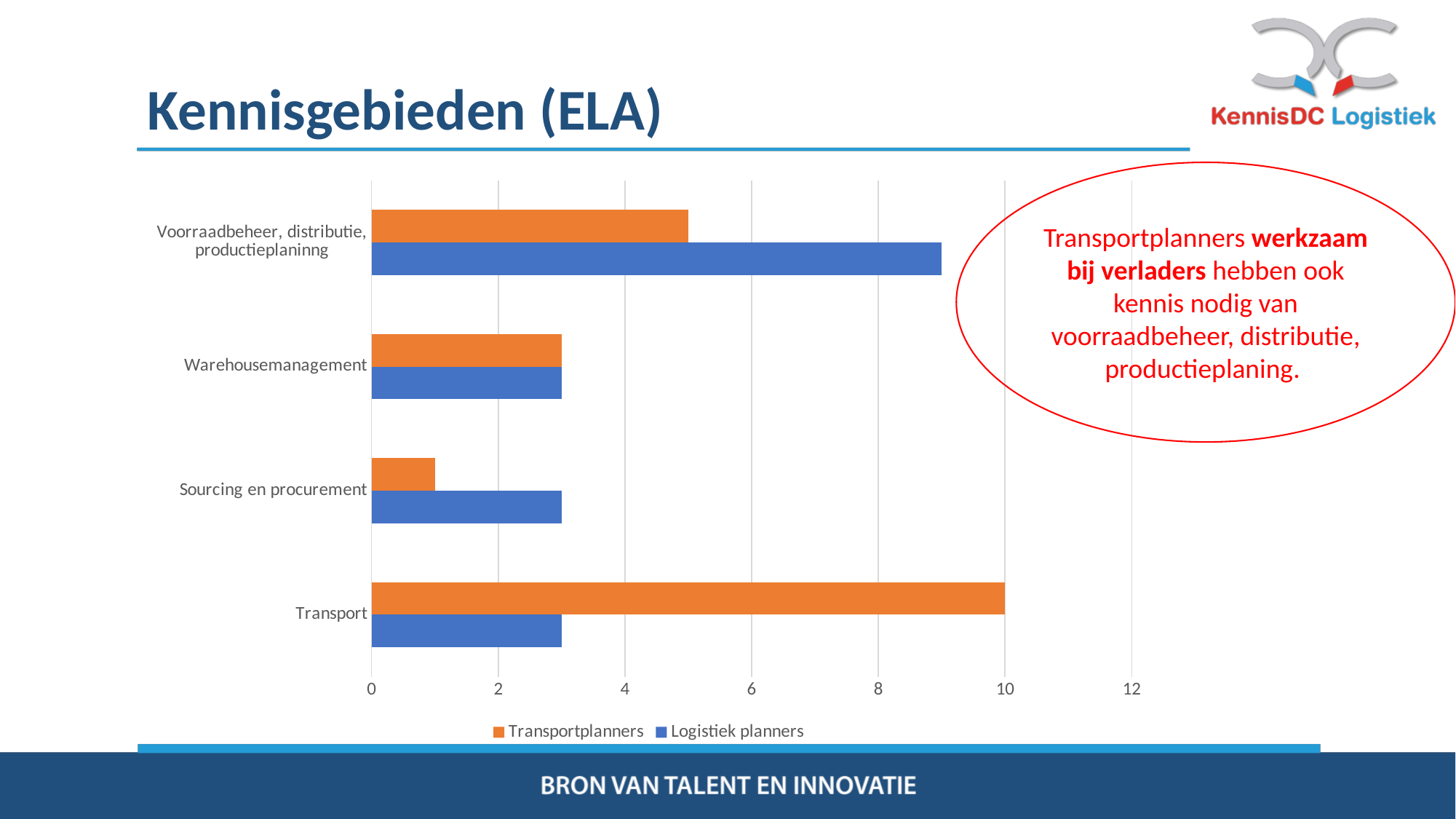
Which series is shown in orange in the legend? Transportplanners How many categories are shown on the chart? 4 Which category has the highest value for Transportplanners? Transport Is the value for Transportplanners in the Sourcing en procurement category greater or less than 2? less Which category has the lowest value for Transportplanners? Sourcing en procurement Which category has the highest value for Logistiek planners? Voorraadbeheer, distributie, productieplaninng What kind of chart is shown on the slide? bar chart Is the value for Logistiek planners in the Voorraadbeheer, distributie, productieplaninng category greater or less than 8? greater In the Transport category, which series has the larger value, Transportplanners or Logistiek planners? Transportplanners In the Sourcing en procurement category, which series has the larger value, Transportplanners or Logistiek planners? Logistiek planners How many series does the legend list? 2 What is the value for Transportplanners in the Transport category? 10